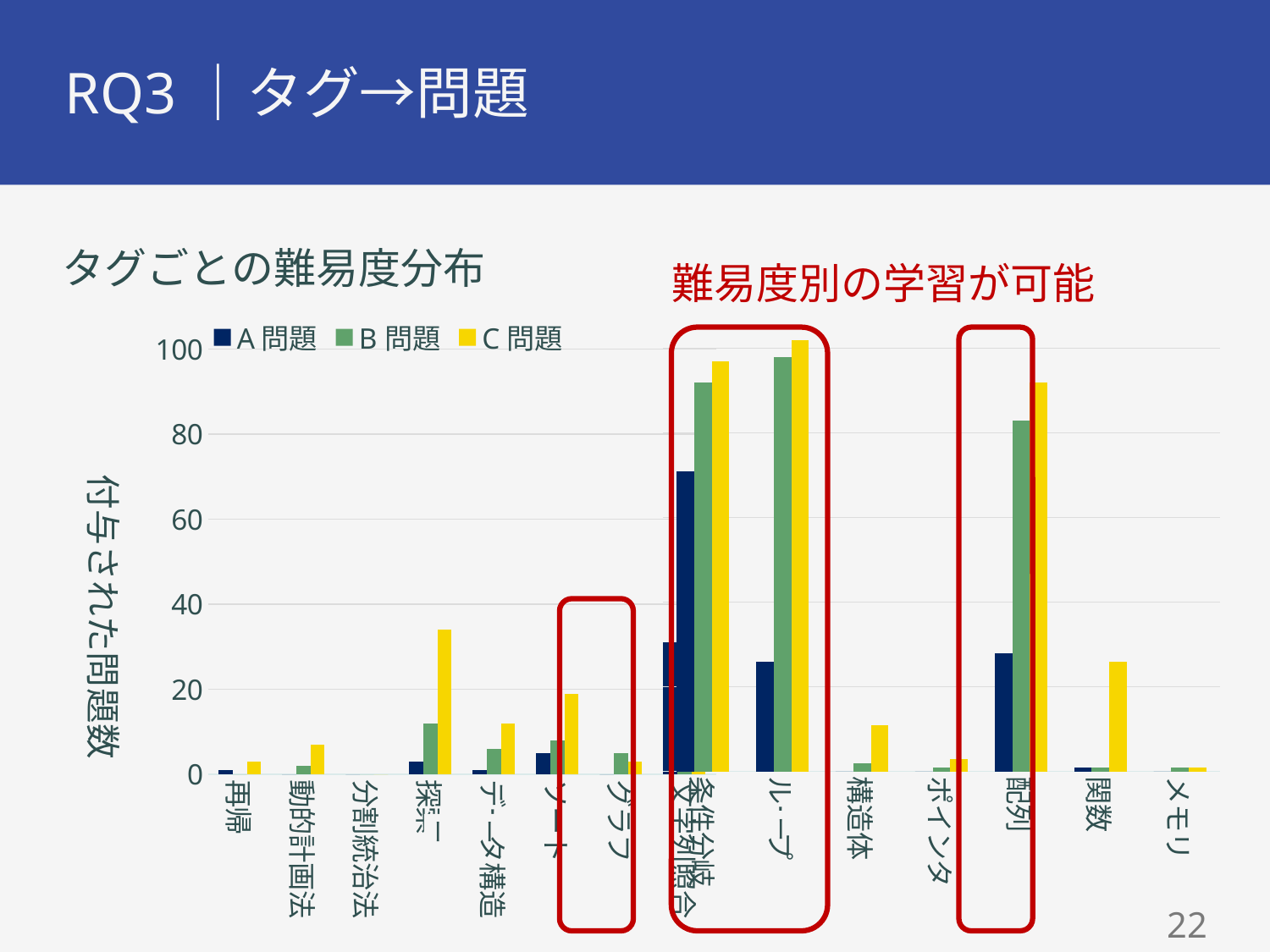
How many series does the legend list? 3 Is the value of A 問題 for 条件分岐 greater or less than 60? greater Which category has the highest C 問題 value? ループ Which has the larger A 問題 value: 条件分岐 or 配列? 条件分岐 Is the value of C 問題 for ループ greater or less than 100? greater Is the value of B 問題 for 配列 greater or less than 80? greater For 条件分岐, which is larger: A 問題 or B 問題? B 問題 What kind of chart is shown on the slide? bar chart How many categories are shown on the x axis? 14 What is the title of the y axis? 付与された問題数